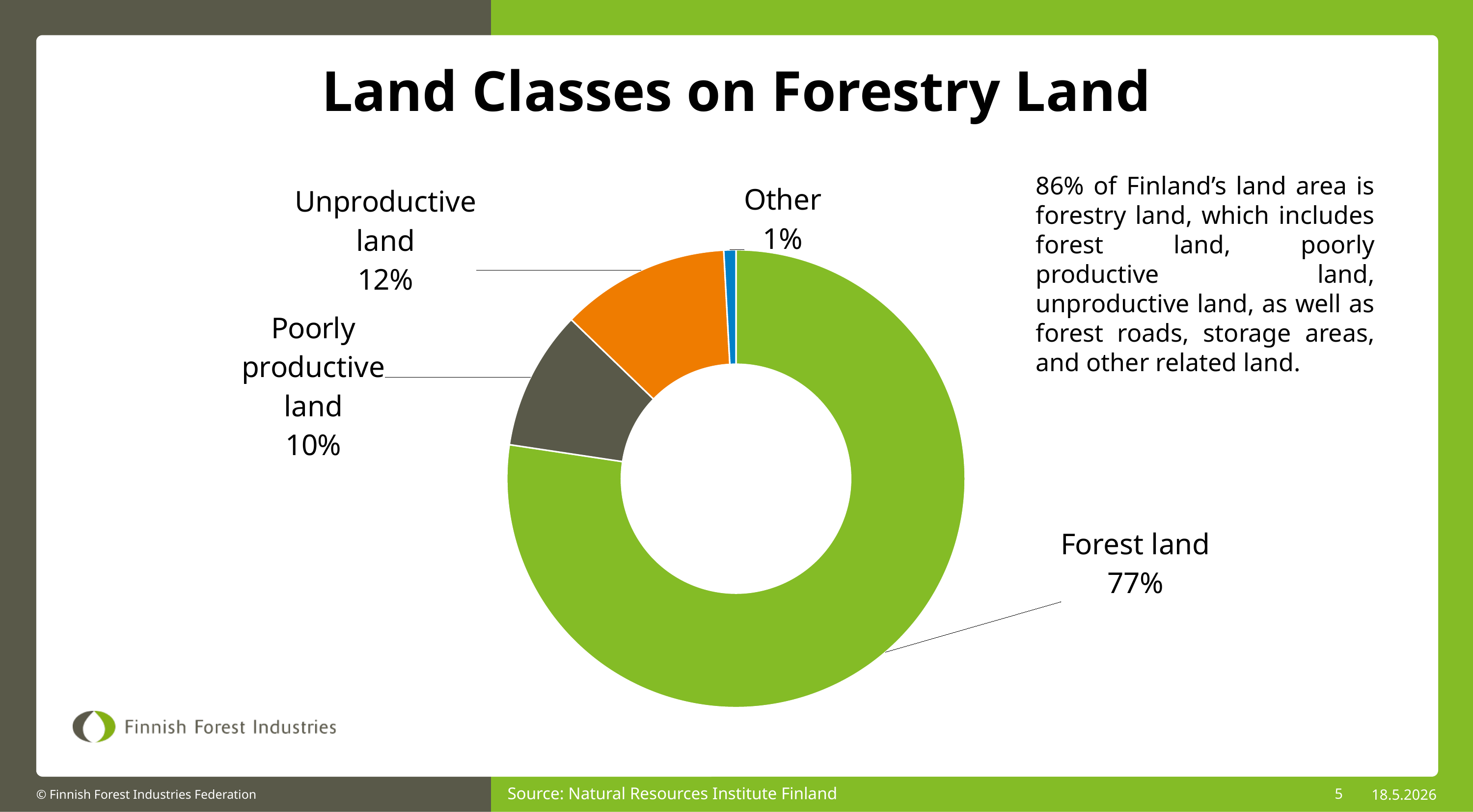
What is the title of the slide? Land Classes on Forestry Land How many land classes are shown in the chart? 4 What kind of chart is shown on the slide? Doughnut (pie) chart What share of forestry land is Poorly productive land? 10% Which land class has the largest share of the chart? Forest land Which land class has the smallest share of the chart? Other What is the difference in percentage points between Unproductive land and Poorly productive land? 2 What is the difference in percentage points between Forest land and Unproductive land? 65 What share of forestry land is Forest land? 77% What share of forestry land is labelled Other? 1% What share of forestry land is Unproductive land? 12% Which has a larger share, Unproductive land or Poorly productive land? Unproductive land